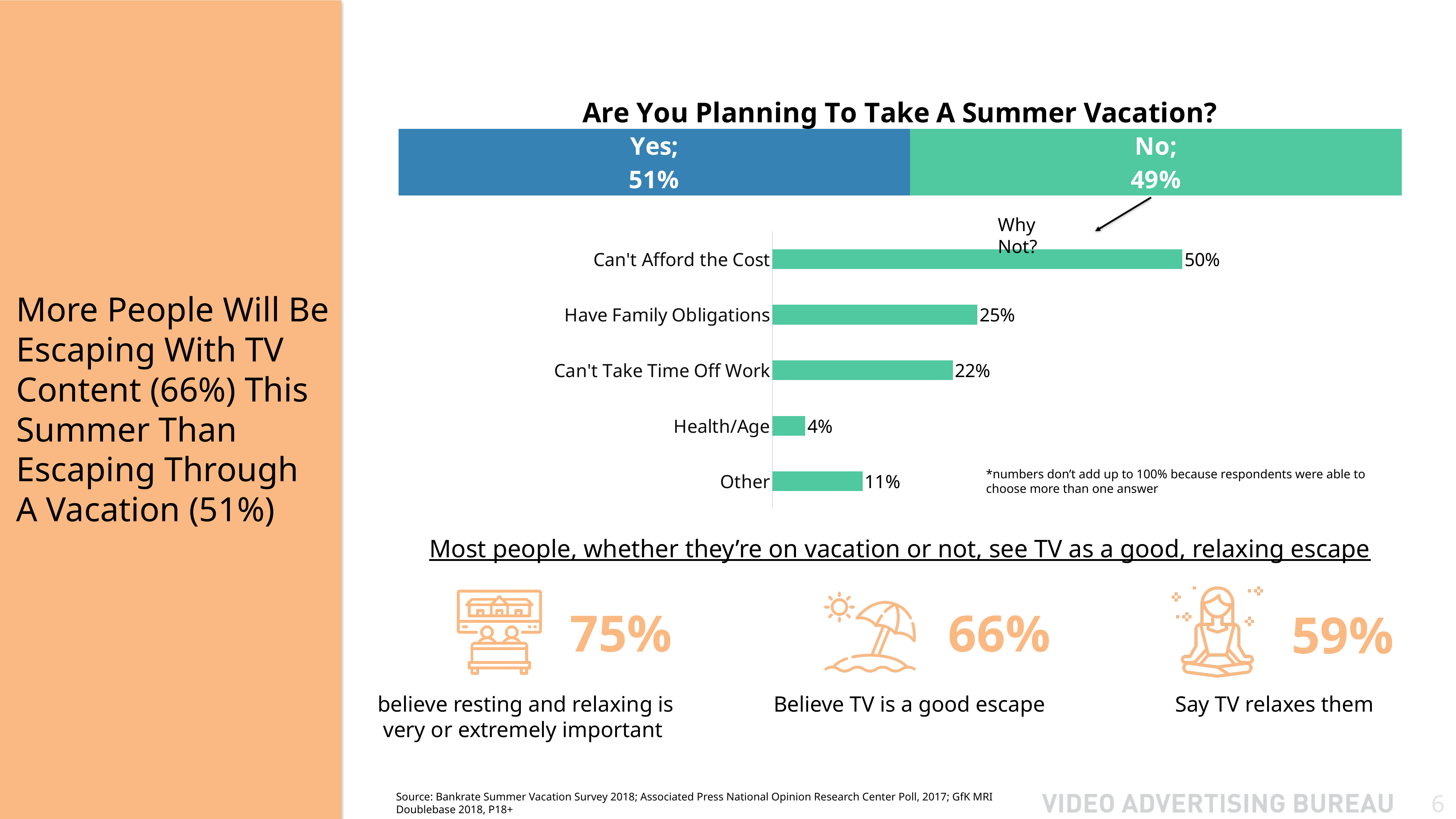
How many reasons are listed in the 'Why Not?' chart? 5 In the 'Are You Planning To Take A Summer Vacation?' chart, what percentage answered Yes? 51% In the 'Why Not?' chart, what is the value for Can't Afford the Cost? 50% In the 'Are You Planning To Take A Summer Vacation?' chart, what is the difference between the Yes and No percentages? 2% In the 'Why Not?' chart, what is the difference between Have Family Obligations and Can't Take Time Off Work? 3% What type of chart is the 'Why Not?' chart? Bar chart In the 'Why Not?' chart, which reason has the lowest value? Health/Age In the 'Why Not?' chart, which reason has the highest value? Can't Afford the Cost In the 'Why Not?' chart, what is the value for Health/Age? 4% In the 'Why Not?' chart, what is the value for Have Family Obligations? 25% In the 'Are You Planning To Take A Summer Vacation?' chart, which answer has the larger share, Yes or No? Yes In the 'Are You Planning To Take A Summer Vacation?' chart, what percentage answered No? 49%